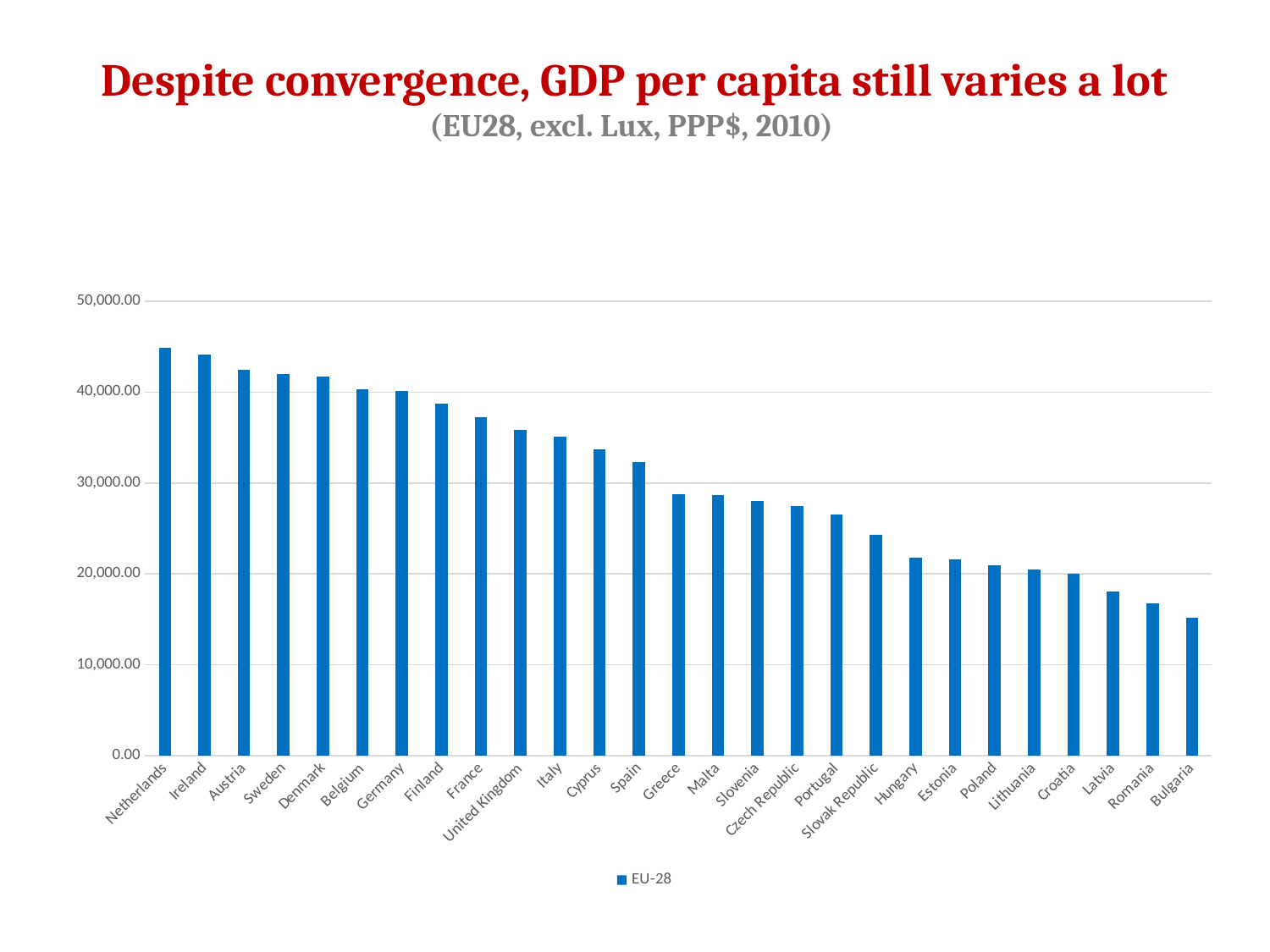
Which country has the lowest GDP per capita in the chart? Bulgaria Is the value for Bulgaria greater or less than 20,000.00? less Which country has the highest GDP per capita in the chart? Netherlands What kind of chart is shown on the slide? Bar chart Is the value for Finland greater or less than 40,000.00? less How many series does the legend list? 1 Do the values rise or fall moving from left to right along the x axis? Fall What is the name of the series shown in the legend? EU-28 Is the value for Greece greater or less than 30,000.00? less Which has the larger value, Spain or Greece? Spain How many countries are shown on the x axis of the chart? 27